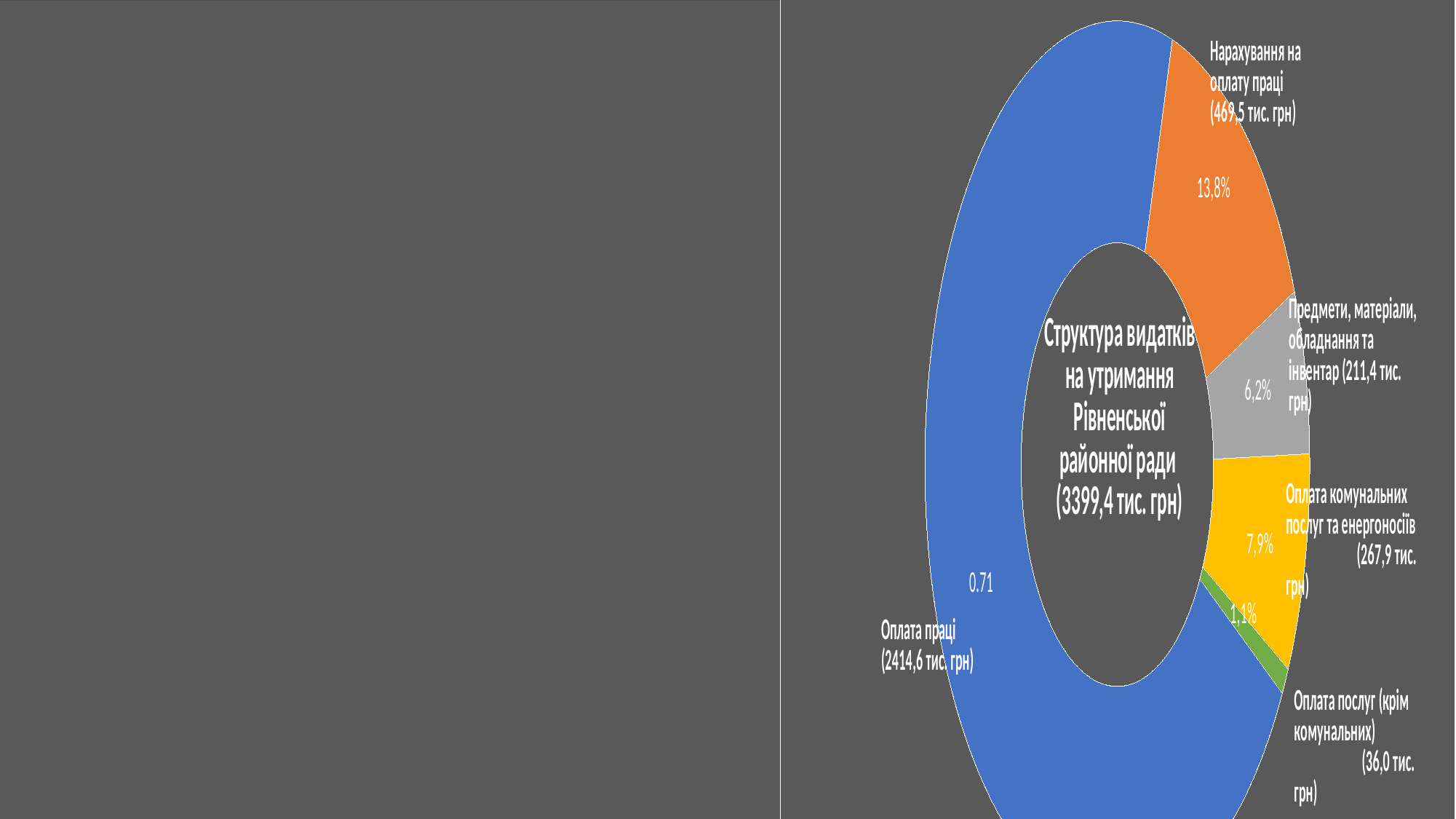
Which is larger: the slice for Нарахування на оплату праці or the slice for Оплата комунальних послуг та енергоносіїв? Нарахування на оплату праці Which category has the largest slice of the doughnut chart? Оплата праці What is the title shown in the centre of the doughnut chart? Структура видатків на утримання Рівненської районної ради (3399,4 тис. грн) What percentage label is shown on the slice for Нарахування на оплату праці? 13,8% What kind of chart is shown on the slide? Doughnut (pie) chart What percentage label is shown on the slice for Оплата послуг (крім комунальних)? 1,1% What amount in тис. грн is given for Оплата праці? 2414,6 тис. грн What amount in тис. грн is given for Оплата послуг (крім комунальних)? 36,0 тис. грн What percentage label is shown on the slice for Оплата комунальних послуг та енергоносіїв? 7,9% Which category has the smallest slice of the doughnut chart? Оплата послуг (крім комунальних) How many categories does the doughnut chart show? 5 What percentage label is shown on the slice for Предмети, матеріали, обладнання та інвентар? 6,2%